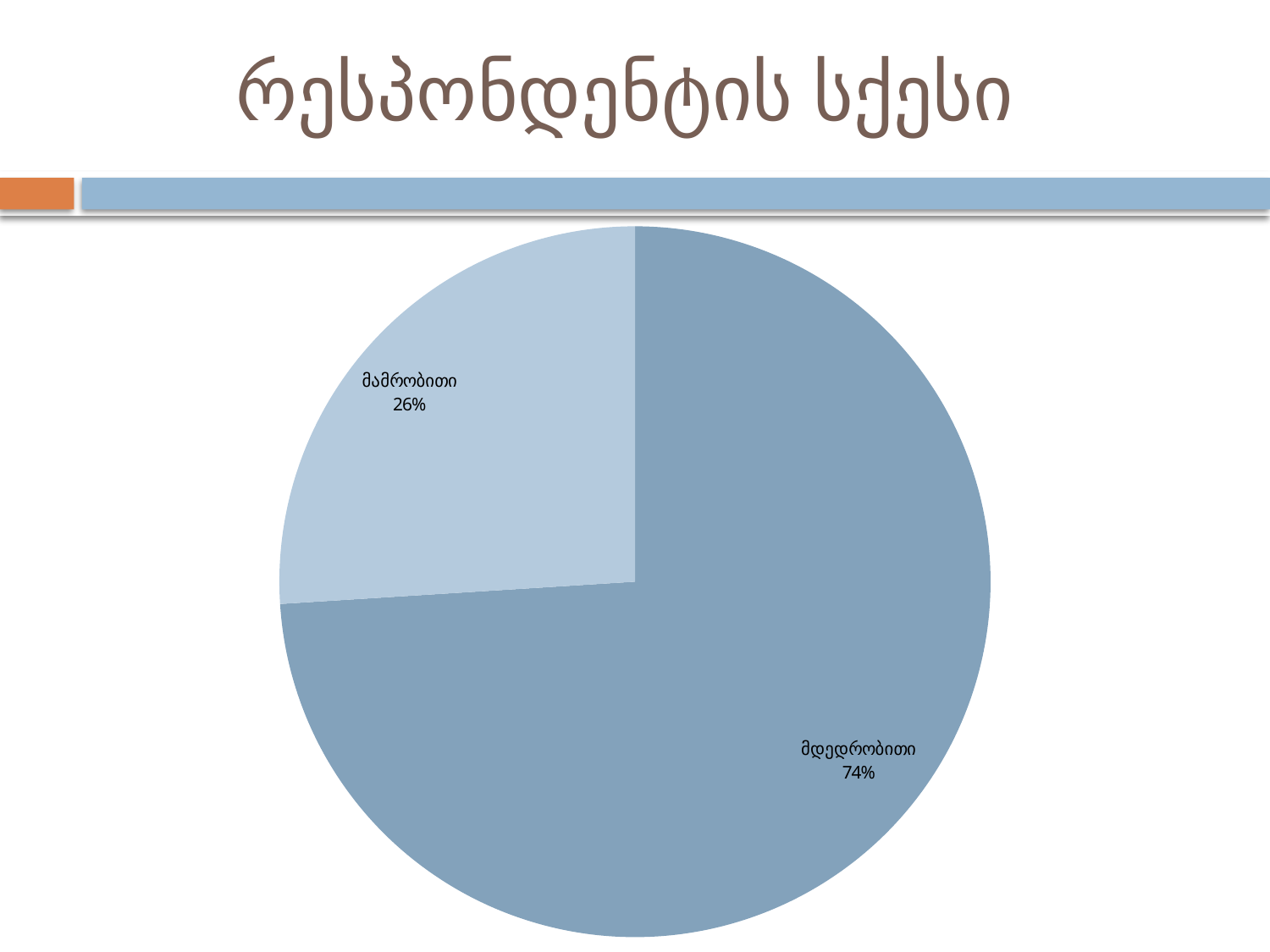
What share of the pie does მდედრობითი have? 74% Which is larger, მამრობითი or მდედრობითი? მდედრობითი What is the title of the slide? რესპონდენტის სქესი What is the difference between the მდედრობითი and მამრობითი shares? 48% How many slices does the pie chart have? 2 Which slice is the largest? მდედრობითი Which slice is the smallest? მამრობითი Which slice is shown in the lighter blue colour? მამრობითი What kind of chart is shown on the slide? pie chart What share of the pie does მამრობითი have? 26%